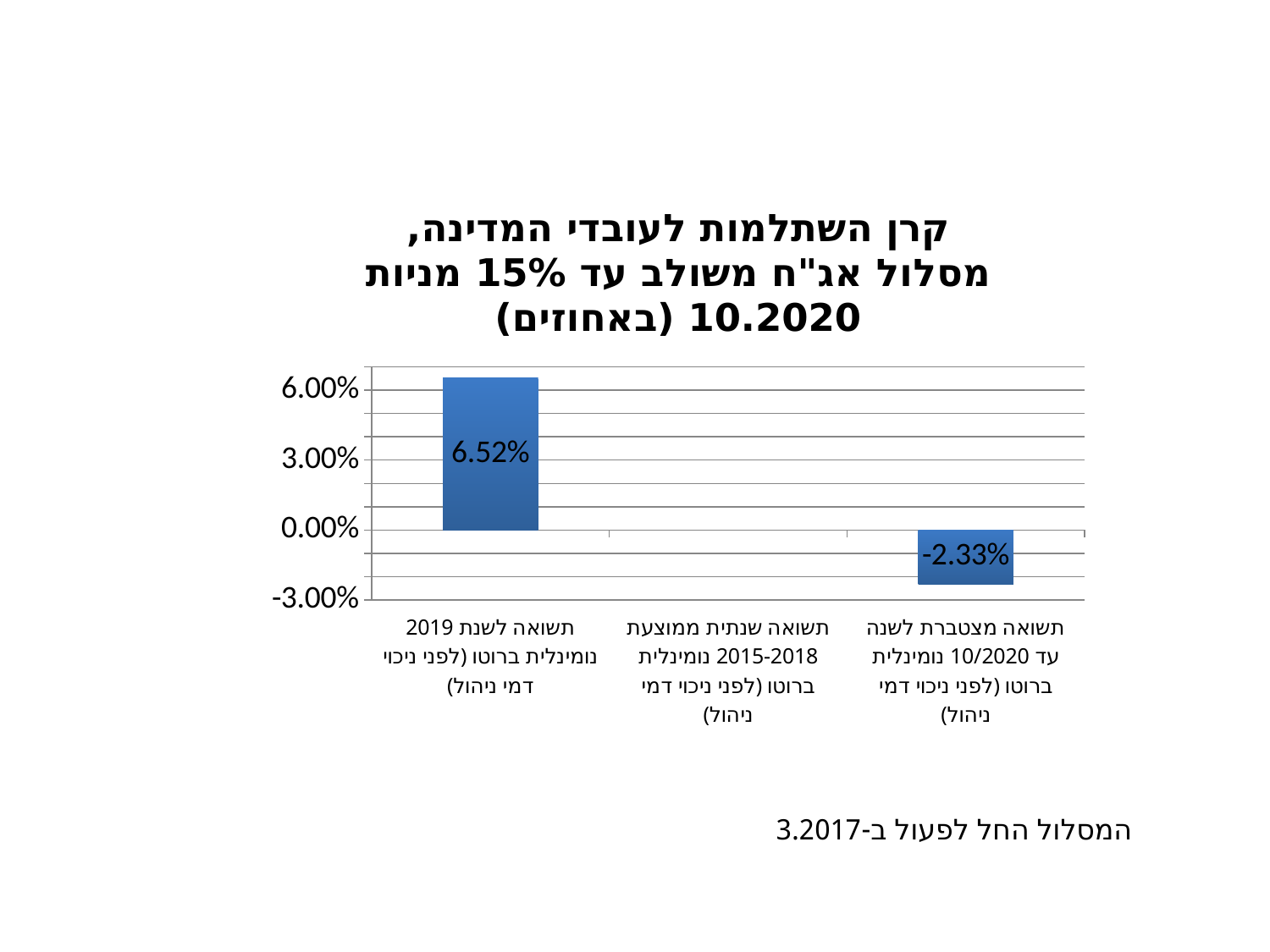
Which category has the highest value? תשואה לשנת 2019 נומינלית ברוטו (לפני ניכוי דמי ניהול) What is the difference between the 2019 return (6.52%) and the cumulative return to 10/2020 (-2.33%)? 8.85 percentage points What is the title of the chart? קרן השתלמות לעובדי המדינה, מסלול אג"ח משולב עד 15% מניות 10.2020 (באחוזים) Which category has no bar plotted? תשואה שנתית ממוצעת 2015-2018 נומינלית ברוטו (לפני ניכוי דמי ניהול) What is the value for the category "תשואה מצטברת לשנה עד 10/2020 נומינלית ברוטו (לפני ניכוי דמי ניהול)"? -2.33% How many categories are shown on the x axis? 3 Is the value for the cumulative return to 10/2020 greater or less than 0.00%? less What is the value for the category "תשואה לשנת 2019 נומינלית ברוטו (לפני ניכוי דמי ניהול)"? 6.52% Is the value for the 2019 return greater or less than 6.00%? greater Which is larger: the return for 2019 or the cumulative return to 10/2020? The return for 2019 Which category has the lowest plotted value? תשואה מצטברת לשנה עד 10/2020 נומינלית ברוטו (לפני ניכוי דמי ניהול) What kind of chart is shown on the slide? Bar chart